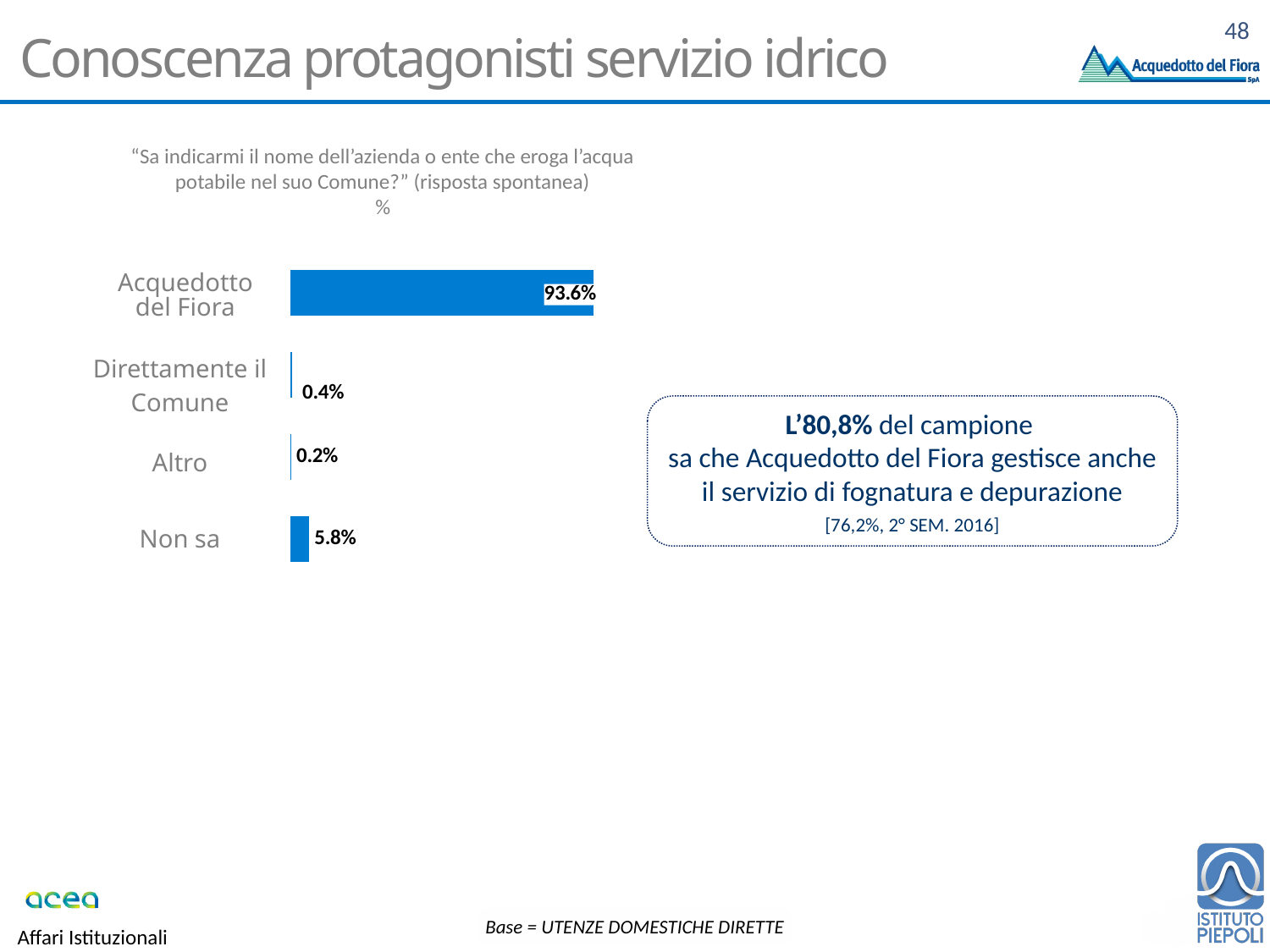
What percentage of respondents named Acquedotto del Fiora as the company supplying drinking water in their municipality? 93.6% Which category has the highest value in the chart? Acquedotto del Fiora How many categories are shown in the chart? 4 What is the difference between the values for 'Acquedotto del Fiora' and 'Non sa'? 87.8% What kind of chart is shown on the slide? Bar chart What is the value shown for 'Altro'? 0.2% What is the difference between the values for 'Direttamente il Comune' and 'Altro'? 0.2% Which is larger, the value for 'Non sa' or the value for 'Direttamente il Comune'? Non sa What is the value shown for 'Non sa'? 5.8% What colour are the bars in the chart? Blue What is the value shown for 'Direttamente il Comune'? 0.4% Which category has the lowest value in the chart? Altro